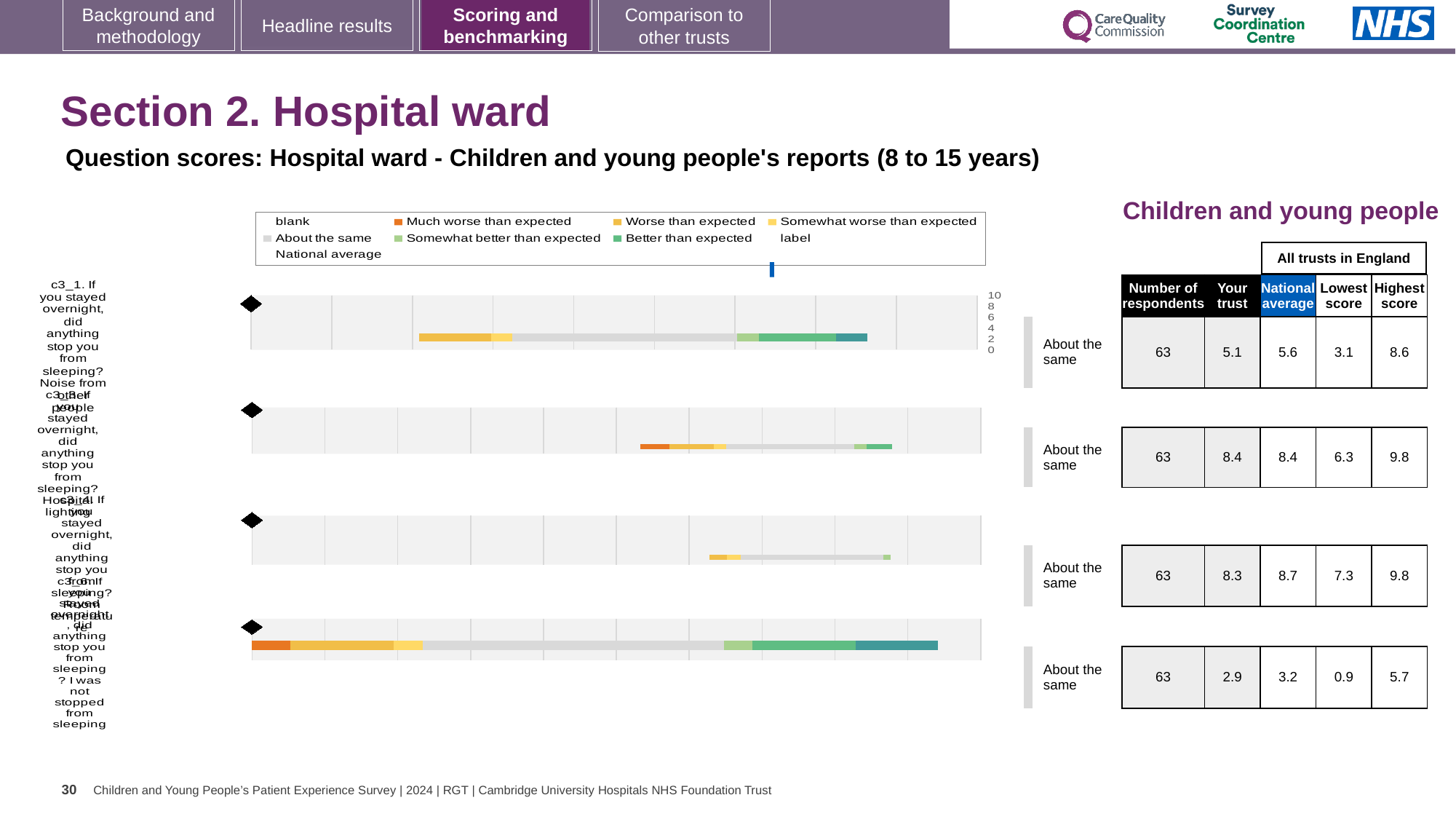
In the table beside the chart, how many respondents are listed for the fourth (bottom) question row? 63 In the chart legend, what colour represents 'About the same'? grey In the table beside the chart, what is the national average for the second question row? 8.4 In the table beside the chart, what is the 'Your trust' score for the first (top) question row? 5.1 In the table beside the chart, which question row has the lowest 'Your trust' score? the fourth (bottom) row (2.9) In the table beside the chart, which question row has the highest 'Your trust' score? the second row (8.4) How many entries does the chart legend list? 9 In the table beside the chart, what is the difference between the highest score and the lowest score for the first question row? 5.5 In the chart legend, what colour represents 'Much worse than expected'? orange In the table beside the chart, is the 'Your trust' score for the third question row larger or smaller than its national average? smaller What kind of chart is shown on the slide? bar chart How many bars (question rows) does the chart contain? 4